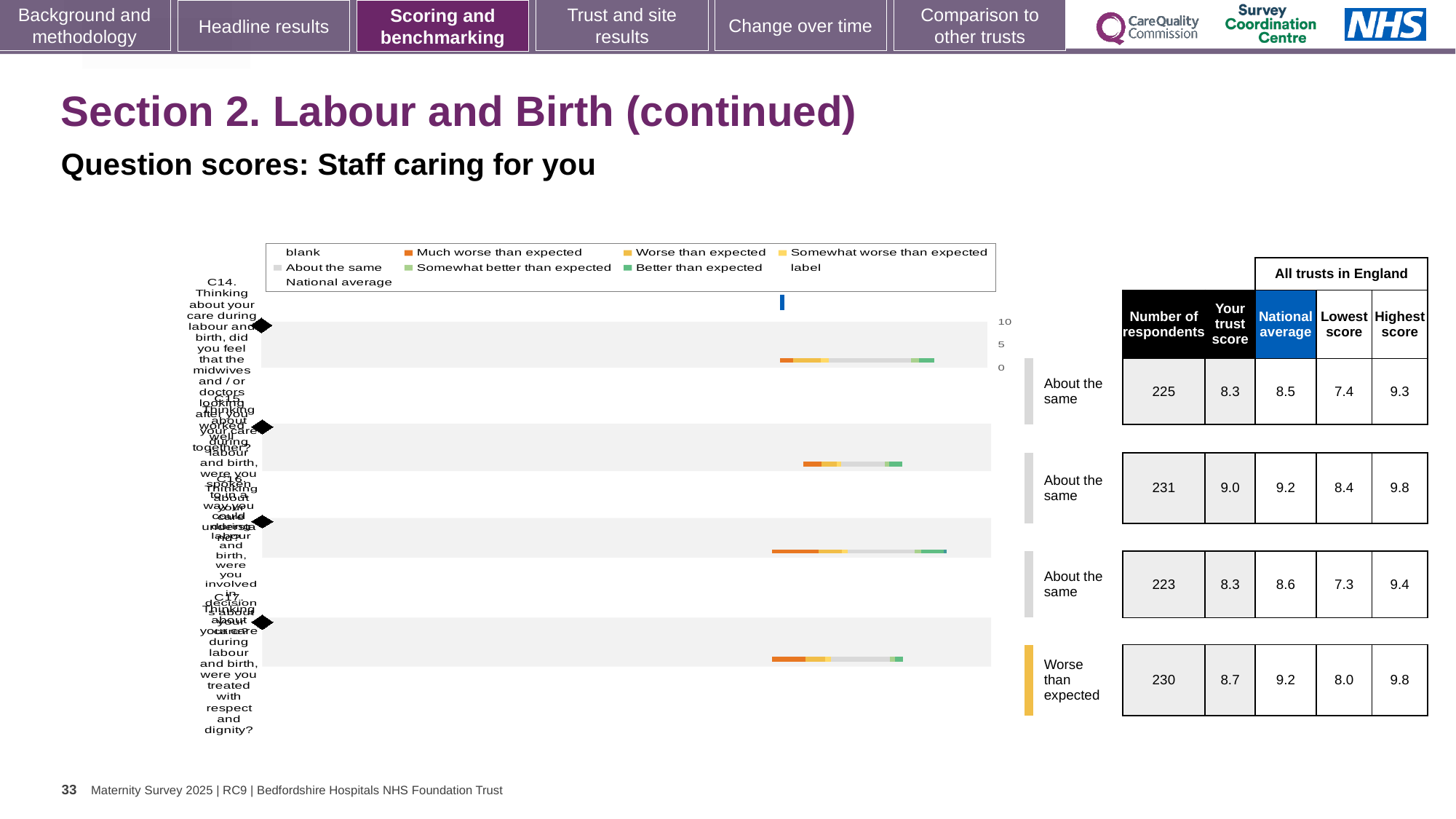
What is the number of respondents for the first (top) question row? 225 For the bottom row rated 'Worse than expected', what is the difference between the national average and your trust score? 0.5 What kind of chart is shown on the slide? bar chart What is the highest score for the third question row? 9.4 In the chart legend, what colour represents 'Much worse than expected'? orange In the chart legend, what colour represents 'Better than expected'? green How many of the question rows are rated 'About the same'? 3 Which question row has the highest 'Your trust score'? the second row (9.0) Which question row has the lowest value in the 'Lowest score' column? the third row (7.3) Which is larger, the lowest score for the second row or the lowest score for the third row? the second row (8.4) How many question rows (bars) does the chart show? 4 What is 'Your trust score' for the bottom question row, rated 'Worse than expected'? 8.7